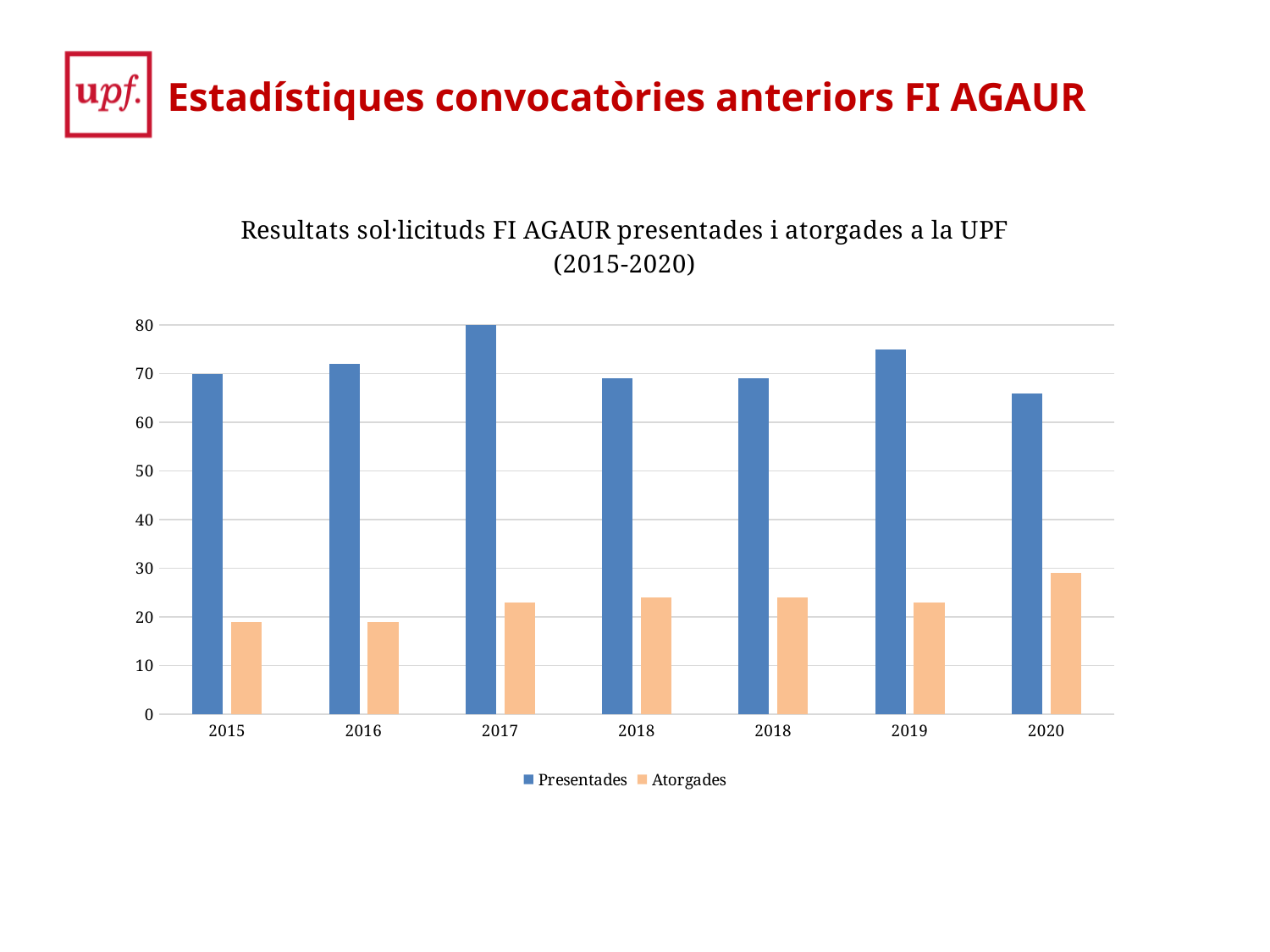
How many year categories are shown on the x axis? 7 Which year has the highest Atorgades value? 2020 Which year has the highest Presentades value? 2017 What kind of chart is shown on the slide? bar chart What is the value of Presentades for 2015? 70 Which is larger, the Presentades value for 2019 or for 2016? 2019 What is the value of Presentades for 2017? 80 How many series does the legend list? 2 Is the Atorgades value for 2020 greater or less than 20? greater Which year has the lowest Presentades value? 2020 What are the two series named in the legend? Presentades and Atorgades